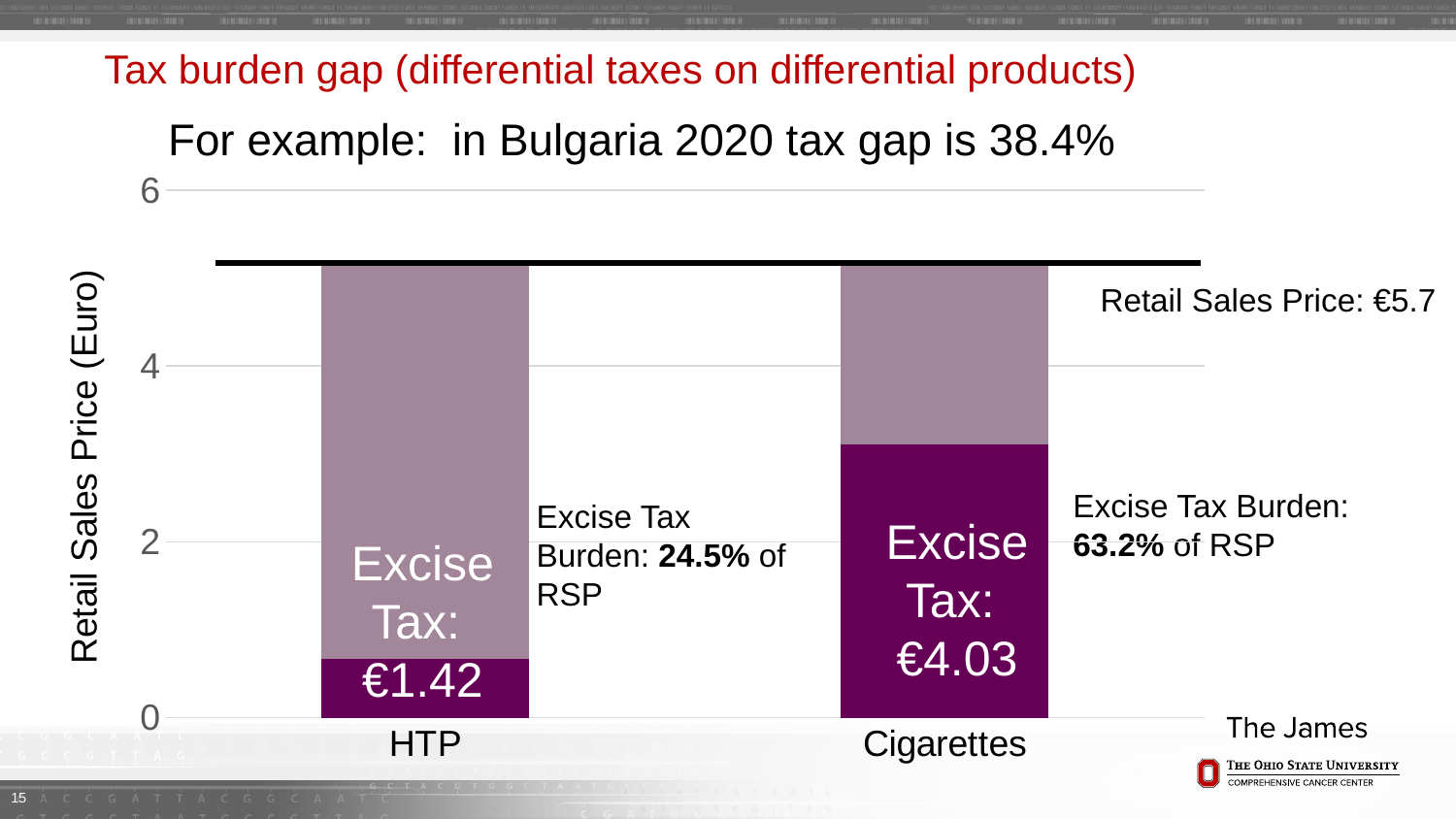
What is the excise tax for Cigarettes? €4.03 What is the excise tax burden as a share of RSP for Cigarettes? 63.2% What is the label of the y axis? Retail Sales Price (Euro) What is the excise tax for HTP? €1.42 What is the difference in excise tax between Cigarettes and HTP? €2.61 Which category has the higher excise tax, HTP or Cigarettes? Cigarettes What kind of chart is shown on the slide? Stacked bar chart How many product categories are shown on the x axis? 2 Which category has the lowest excise tax? HTP What is the excise tax burden as a share of RSP for HTP? 24.5% What is the retail sales price shown for the products? €5.7